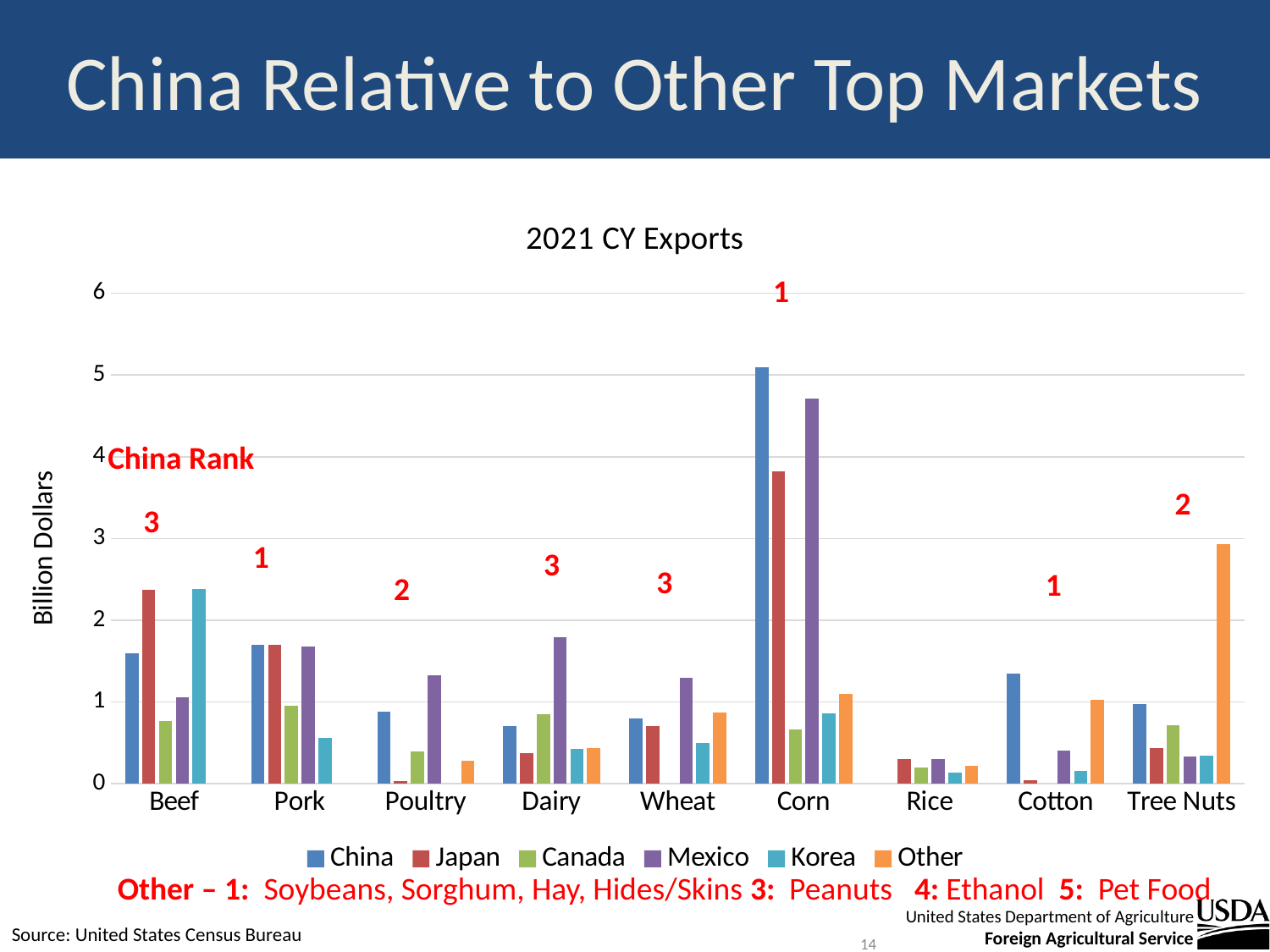
What is the title of the chart? 2021 CY Exports Which series has the tallest bar in Tree Nuts? Other What kind of chart is shown on the slide? Bar chart Is the value for Mexico in Dairy greater or less than 1? greater How many series does the legend list? 6 In Corn, which is larger, the China bar or the Japan bar? China Is the value for China in Corn greater or less than 4? greater How many commodity categories are shown on the x axis? 9 For which commodity is the China bar the tallest? Corn In Beef, which is larger, the Japan bar or the Canada bar? Japan Is the value for Other in Tree Nuts greater or less than 2? greater